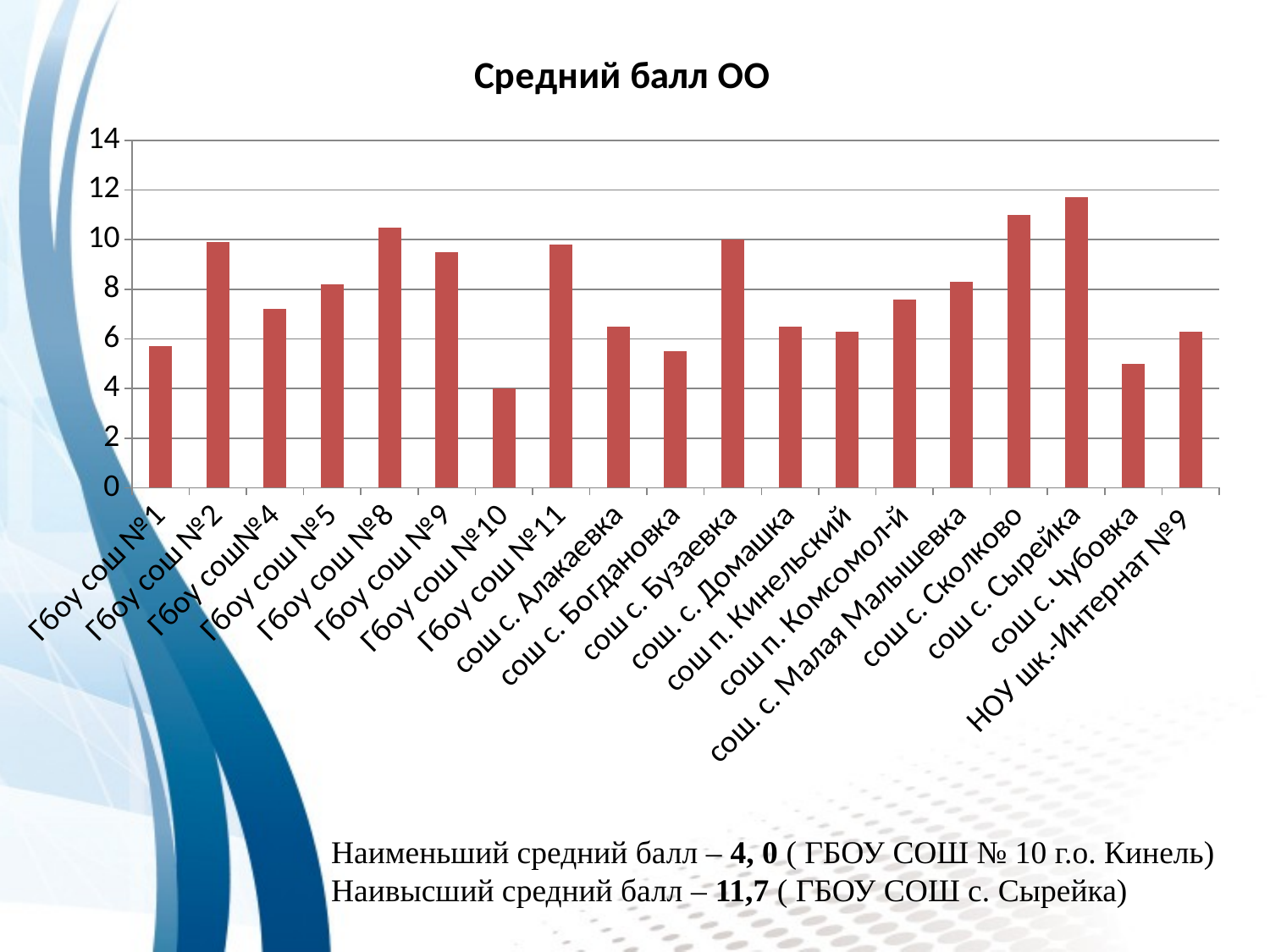
Which school has the lowest average score in the chart? Гбоу сош №10 Which school has the highest average score in the chart? сош с. Сырейка Is the value for Гбоу сош №8 greater or less than 10? greater How many schools (categories) are shown on the x axis of the chart? 19 Which has a higher average score: Гбоу сош №2 or Гбоу сош№4? Гбоу сош №2 What is the difference between the highest average score (сош с. Сырейка) and the lowest (ГБОУ СОШ №10)? 7,7 What is the average score for ГБОУ СОШ №10 according to the slide? 4, 0 What is the title of the chart? Средний балл ОО Is the value for сош с. Богдановка greater or less than 6? less Which has a higher average score: сош с. Сколково or сош с. Чубовка? сош с. Сколково What kind of chart is shown on the slide? bar chart What is the average score for сош с. Сырейка according to the slide? 11,7